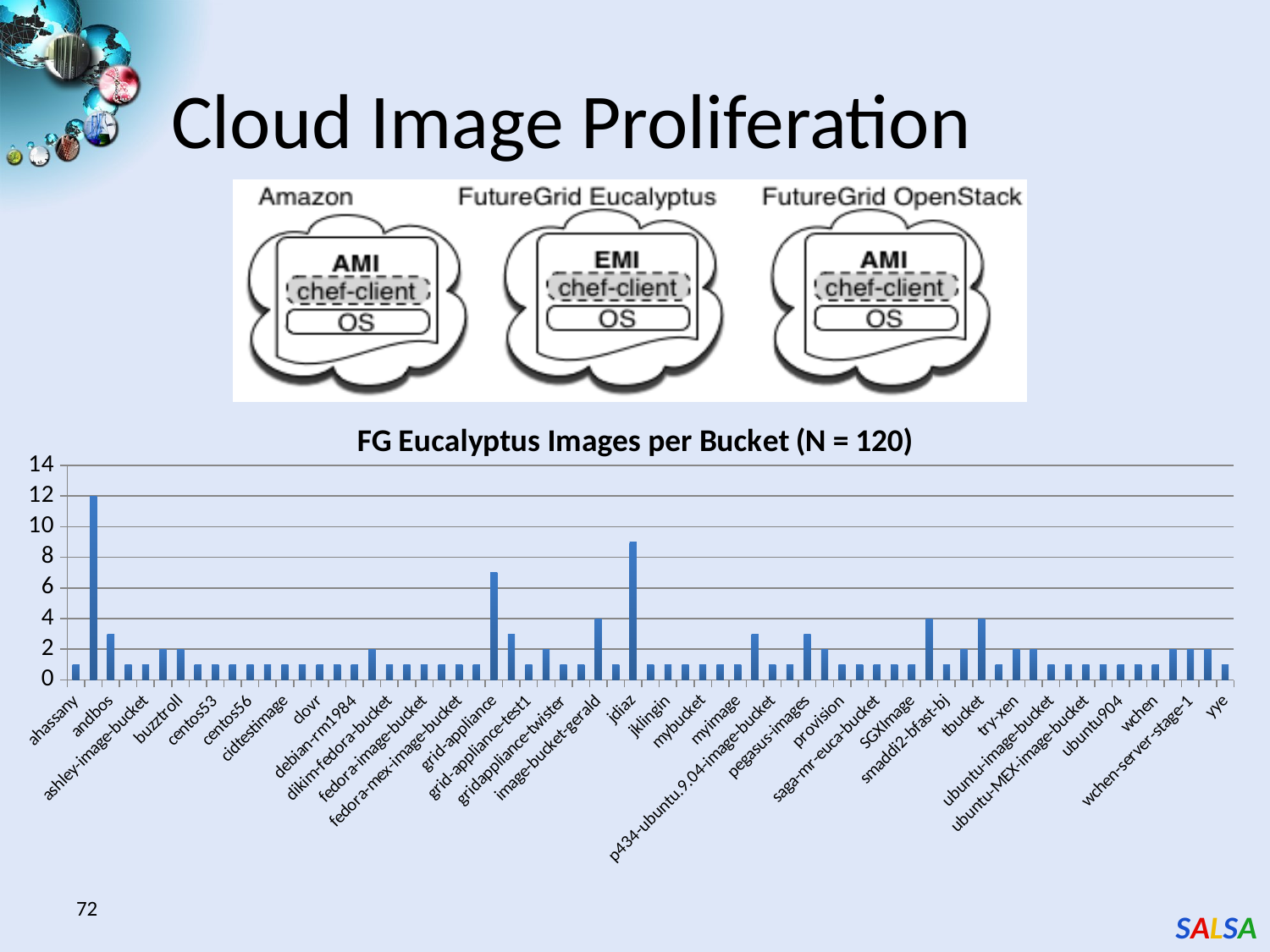
Is the value for jdiaz greater or less than 8? greater What is the value of N given in the chart title? 120 What is the highest value reached by any bar in the chart? 12 Which bucket has more images, jdiaz or grid-appliance? jdiaz How many images does the tbucket bucket have? 4 What is the title of the chart? FG Eucalyptus Images per Bucket (N = 120) What kind of chart is shown on the slide? bar chart